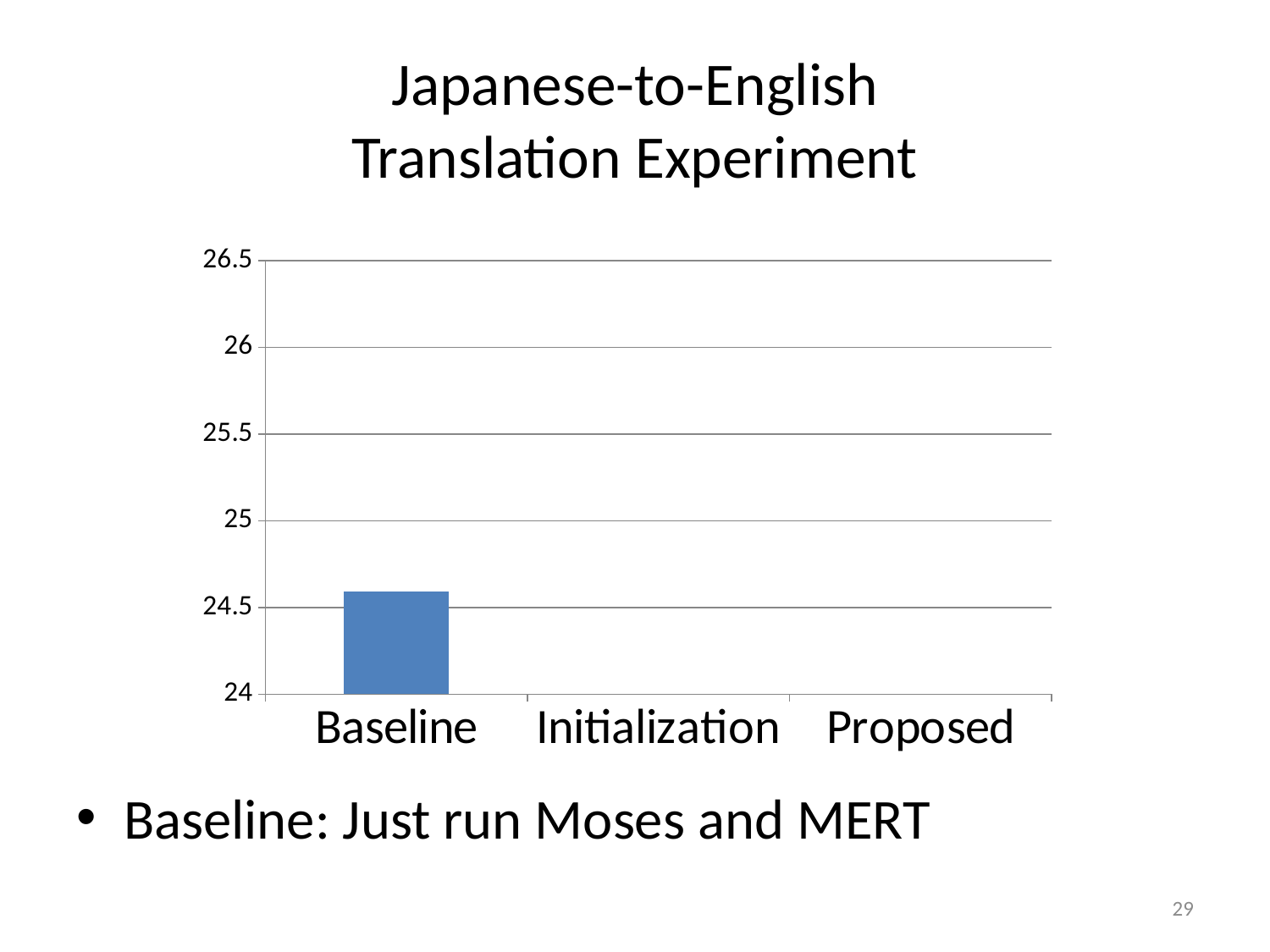
What is the highest value shown on the y axis of the chart? 26.5 Is the value for Baseline greater or less than 26? less Which category is the only one with a bar plotted on the chart? Baseline Is the value for Baseline greater or less than 24.5? greater What are the three category labels on the x axis, from left to right? Baseline, Initialization, Proposed How many categories are labelled on the x axis of the chart? 3 What is the lowest value shown on the y axis of the chart? 24 Is the value for Baseline greater or less than 25? less What kind of chart is shown on the slide? bar chart What is the title of the slide containing the chart? Japanese-to-English Translation Experiment